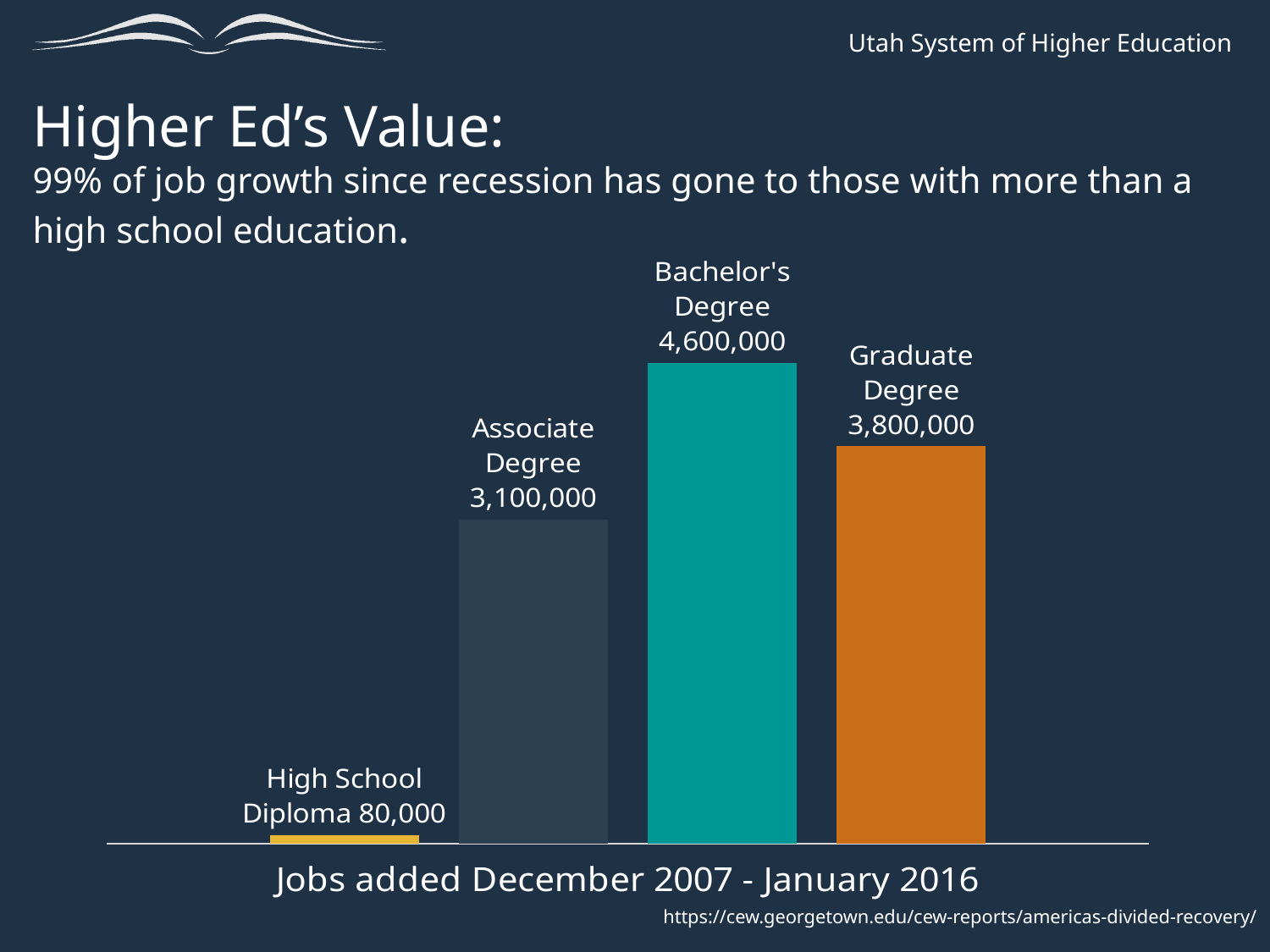
How many jobs were added for those with a Graduate Degree? 3,800,000 How many jobs were added for those with an Associate Degree? 3,100,000 Which had more jobs added, Associate Degree or Graduate Degree? Graduate Degree Which education level had the fewest jobs added? High School Diploma Which education level had the most jobs added? Bachelor's Degree What is the difference in jobs added between Associate Degree and High School Diploma? 3,020,000 What type of chart is shown on the slide? Bar chart How many jobs were added for those with a High School Diploma? 80,000 What is the difference in jobs added between Bachelor's Degree and Graduate Degree? 800,000 How many jobs were added for those with a Bachelor's Degree? 4,600,000 How many education categories are shown in the chart? 4 What time period does the chart's axis label say the jobs were added in? December 2007 - January 2016